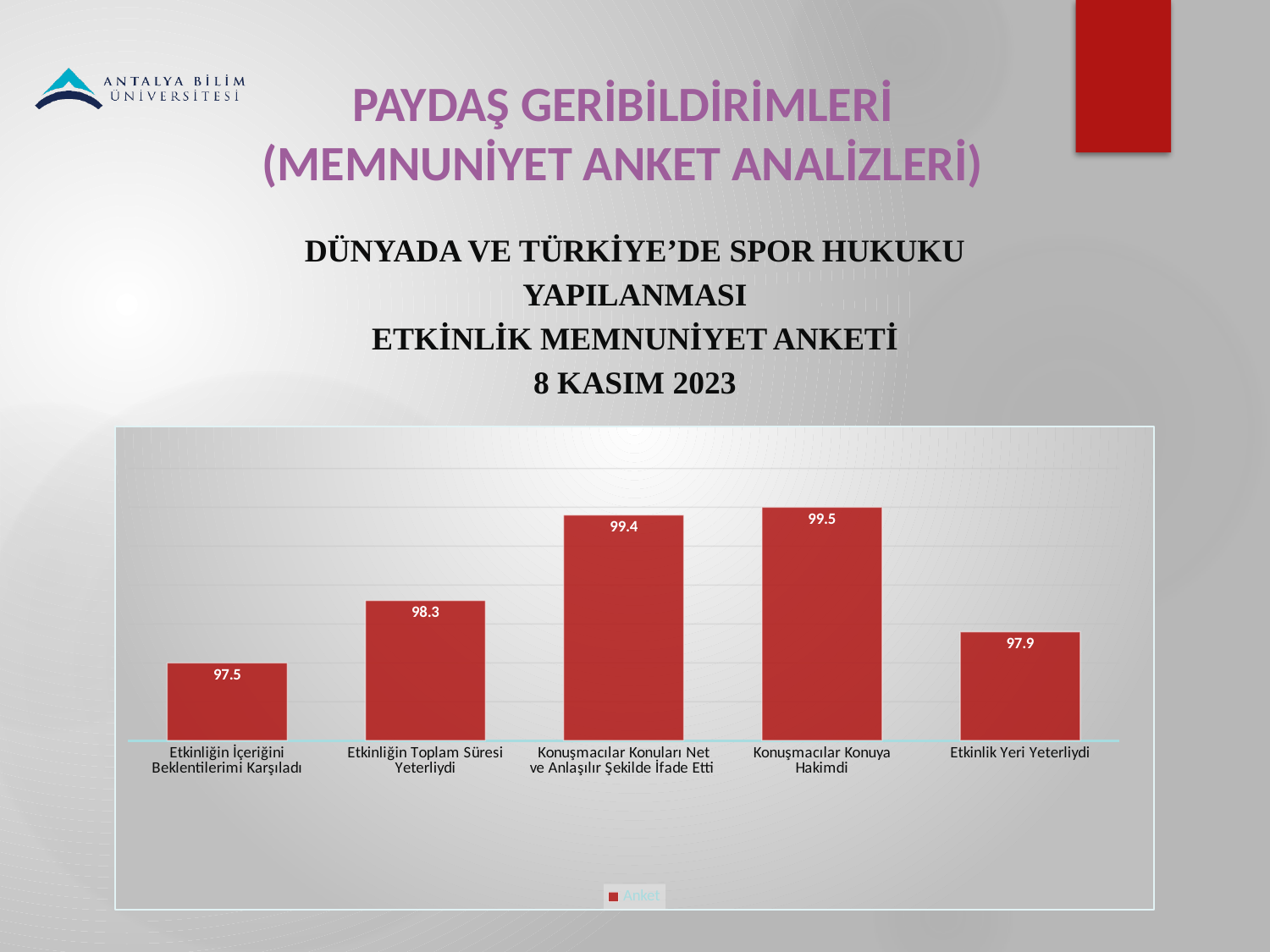
How many categories are shown in the chart? 5 What is the value for "Etkinliğin İçeriğini Beklentilerimi Karşıladı"? 97.5 Which is larger: the value for "Etkinliğin Toplam Süresi Yeterliydi" or the value for "Etkinlik Yeri Yeterliydi"? Etkinliğin Toplam Süresi Yeterliydi Which category has the lowest value? Etkinliğin İçeriğini Beklentilerimi Karşıladı What is the value for "Etkinlik Yeri Yeterliydi"? 97.9 What is the value for "Konuşmacılar Konuya Hakimdi"? 99.5 What is the difference between the values for "Konuşmacılar Konuları Net ve Anlaşılır Şekilde İfade Etti" and "Etkinliğin İçeriğini Beklentilerimi Karşıladı"? 1.9 Which category has the highest value? Konuşmacılar Konuya Hakimdi What is the value for "Etkinliğin Toplam Süresi Yeterliydi"? 98.3 What kind of chart is shown on the slide? Bar chart What is the name of the series shown in the legend? Anket How many series does the legend list? 1